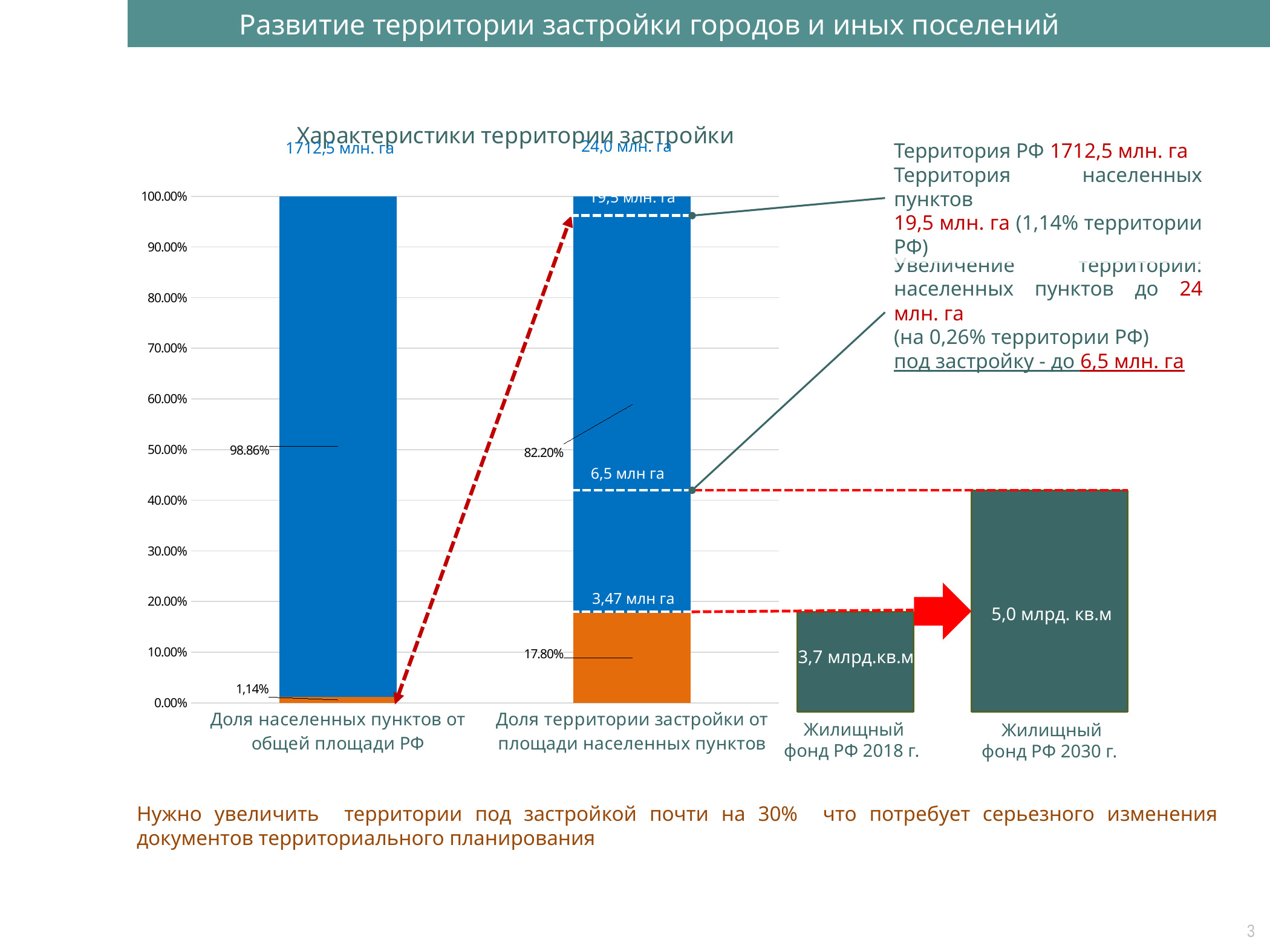
In the chart 'Характеристики территории застройки', what is the value of the blue segment for 'Доля населенных пунктов от общей площади РФ'? 98.86% In the chart 'Характеристики территории застройки', what is the value of the blue segment for 'Доля территории застройки от площади населенных пунктов'? 82.20% In the chart on the right of the slide, do the values rise or fall from 2018 to 2030? Rise In the chart on the right of the slide, what is the value for 'Жилищный фонд РФ 2030 г.'? 5,0 млрд. кв.м In the chart 'Характеристики территории застройки', what is the value of the orange segment for 'Доля территории застройки от площади населенных пунктов'? 17.80% In the chart 'Характеристики территории застройки', which category has the larger orange segment? Доля территории застройки от площади населенных пунктов How many categories are shown on the x axis of the chart 'Характеристики территории застройки'? 2 In the chart 'Характеристики территории застройки', what is the difference between the blue segment values of the two categories (98.86% and 82.20%)? 16.66% What kind of chart is 'Характеристики территории застройки'? Stacked bar chart In the chart on the right of the slide, which category has the highest value? Жилищный фонд РФ 2030 г. In the chart on the right of the slide, what is the value for 'Жилищный фонд РФ 2018 г.'? 3,7 млрд.кв.м In the chart 'Характеристики территории застройки', what is the value of the orange segment for 'Доля населенных пунктов от общей площади РФ'? 1,14%